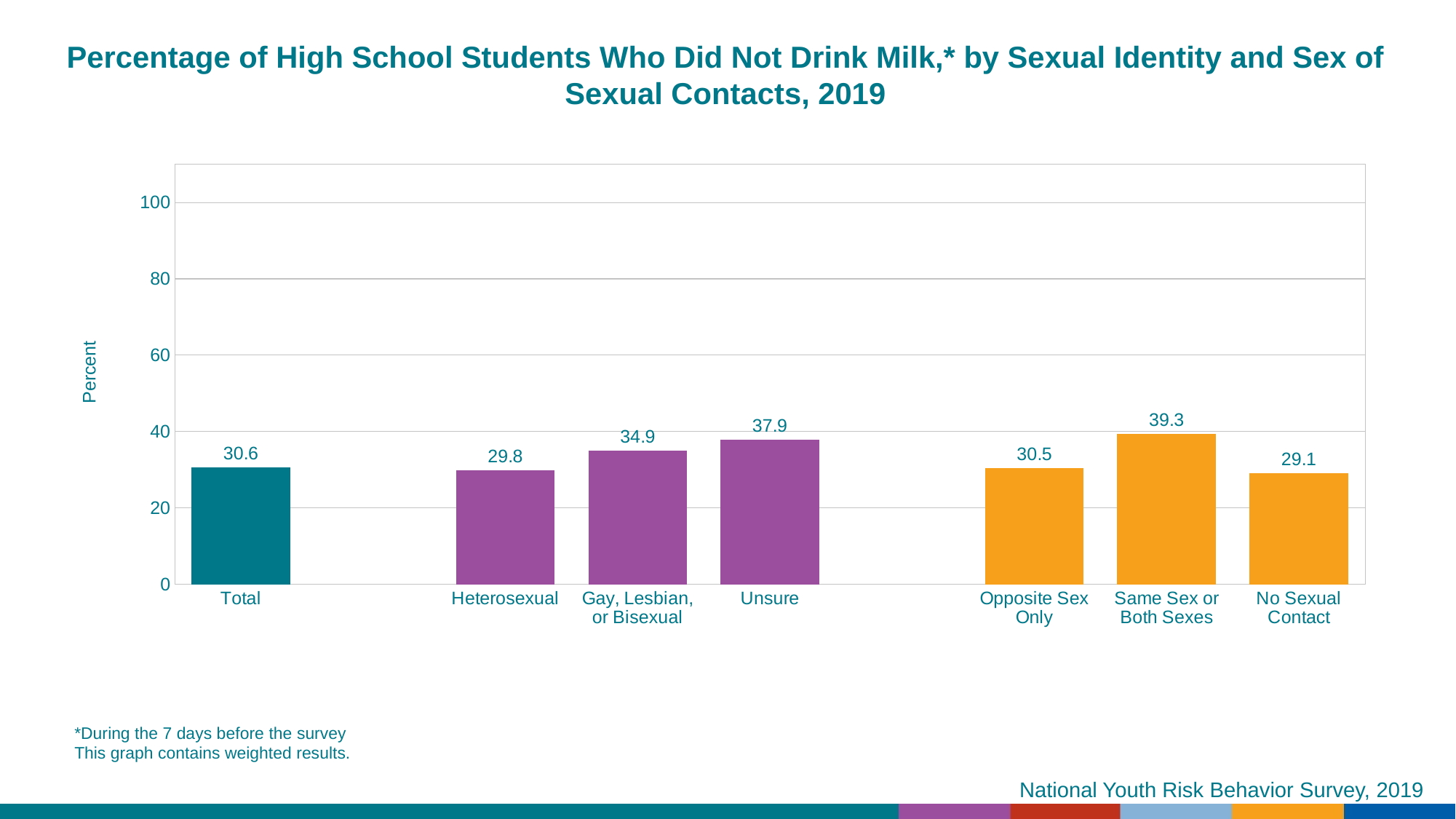
Which category has the lowest percentage of students who did not drink milk? No Sexual Contact What is the value for students with Same Sex or Both Sexes sexual contacts? 39.3 What is the difference between the values for Same Sex or Both Sexes and No Sexual Contact? 10.2 Which is larger, the value for Gay, Lesbian, or Bisexual students or the value for Opposite Sex Only? Gay, Lesbian, or Bisexual What kind of chart is shown on the slide? Bar chart What percentage of students in the Total category did not drink milk? 30.6 What is the value for Heterosexual students? 29.8 Which category has the highest percentage of students who did not drink milk? Same Sex or Both Sexes What is the label of the y axis? Percent What is the difference between the values for Unsure and Heterosexual students? 8.1 How many categories are plotted on the chart? 7 What is the value for Unsure students? 37.9